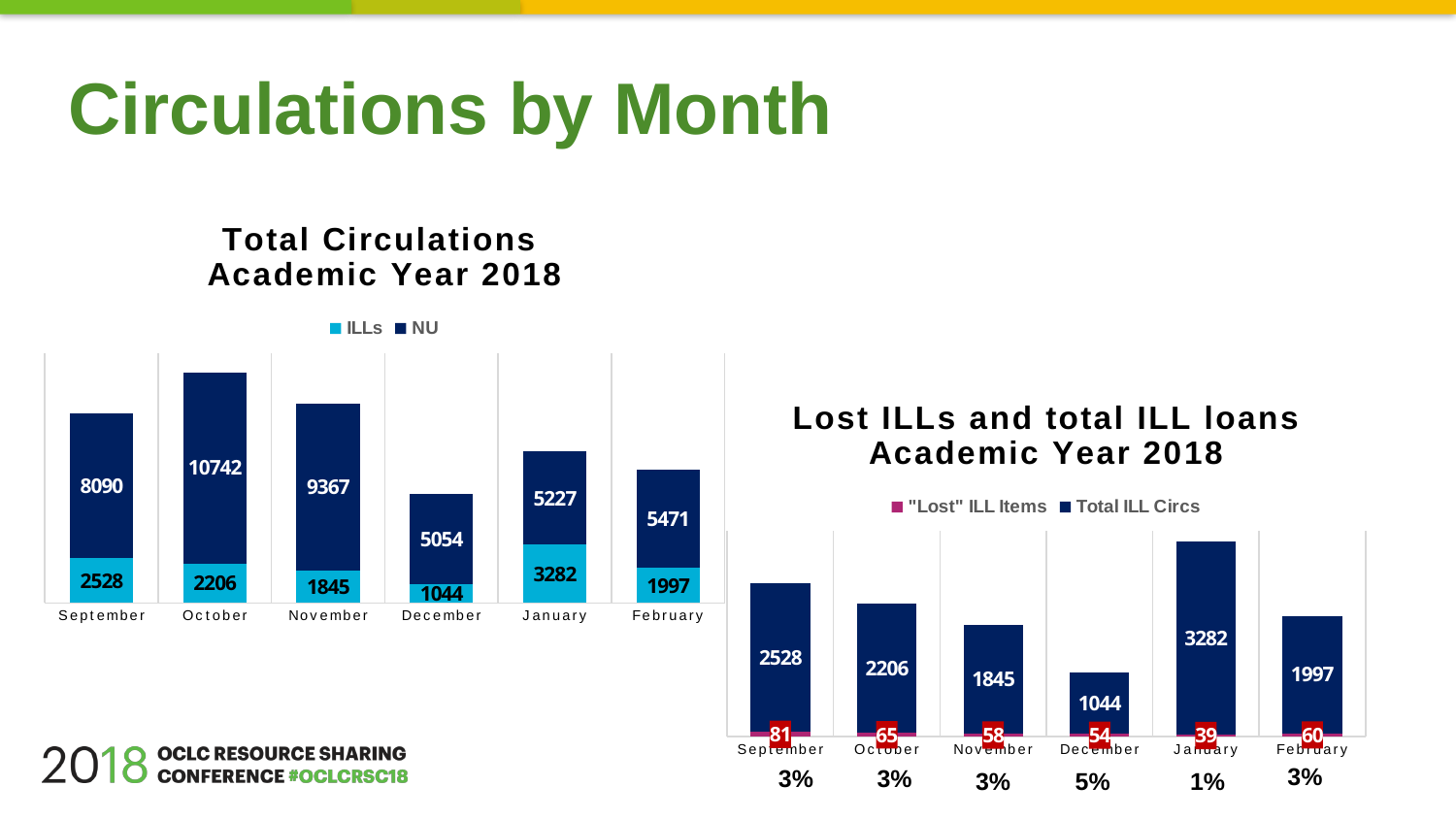
In the Lost ILLs and total ILL loans Academic Year 2018 chart, which month has the lowest "Lost" ILL Items value? January In the Total Circulations Academic Year 2018 chart, what is the ILLs value for January? 3282 In the Lost ILLs and total ILL loans Academic Year 2018 chart, what percentage is shown below December? 5% In the Total Circulations Academic Year 2018 chart, how many series does the legend list? 2 In the Total Circulations Academic Year 2018 chart, what is the total of the stacked bar for October? 12948 In the Total Circulations Academic Year 2018 chart, what is the difference between the NU values for November and December? 4313 In the Total Circulations Academic Year 2018 chart, what is the NU value for October? 10742 In the Total Circulations Academic Year 2018 chart, which month has the lowest ILLs value? December What kind of chart is the Lost ILLs and total ILL loans Academic Year 2018 chart? Stacked bar chart In the Lost ILLs and total ILL loans Academic Year 2018 chart, which is larger, the Total ILL Circs value for October or for February? October In the Total Circulations Academic Year 2018 chart, which month has the highest NU value? October In the Lost ILLs and total ILL loans Academic Year 2018 chart, what is the "Lost" ILL Items value for September? 81